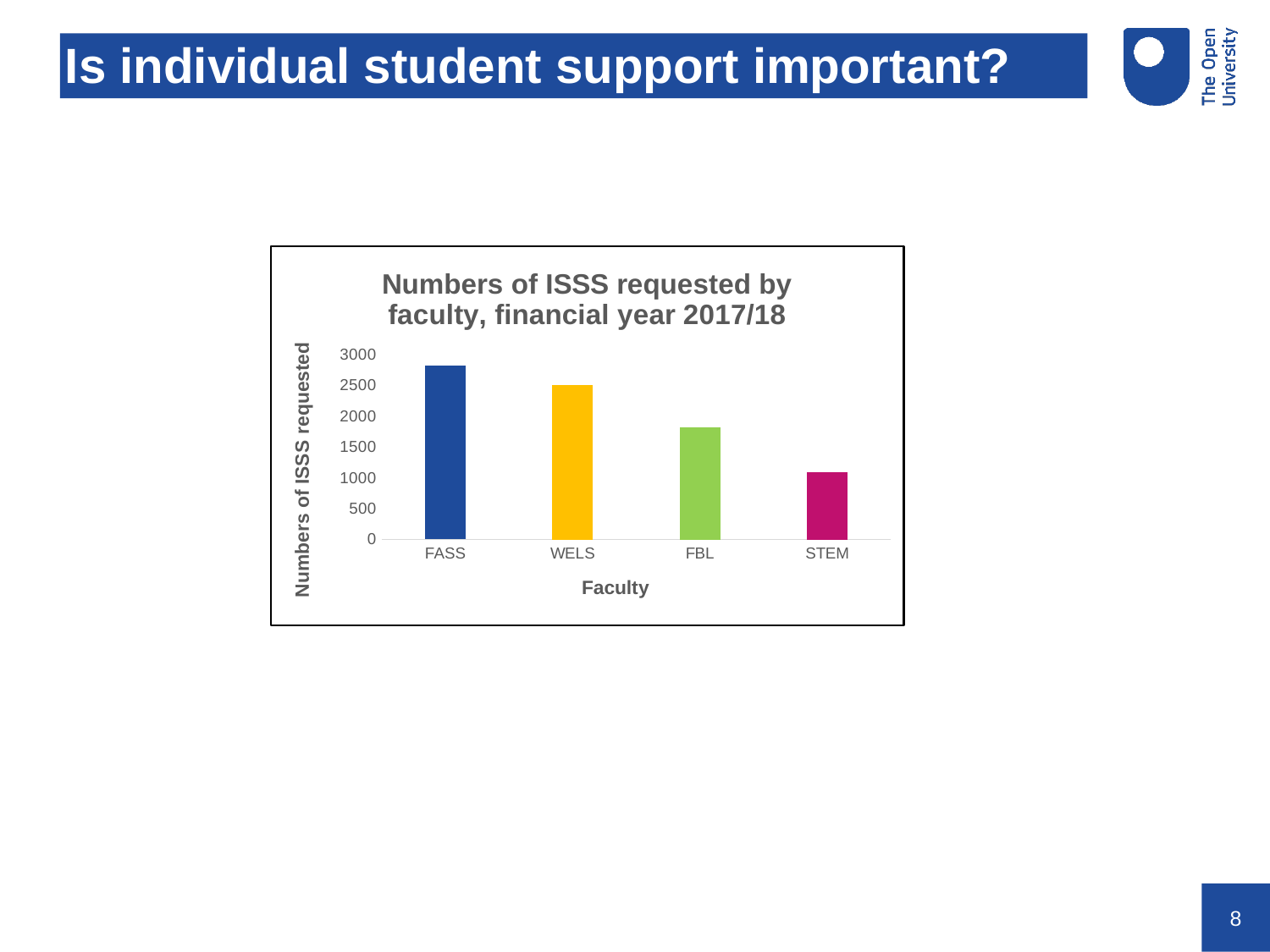
Is the value for FBL greater or less than 2000? less What kind of chart is shown on the slide? Bar chart What is the title of the chart? Numbers of ISSS requested by faculty, financial year 2017/18 Is the value for FASS greater or less than 2500? greater How many faculties are shown on the x axis of the chart? 4 Which faculty has the highest number of ISSS requested? FASS Do the values rise or fall moving from FASS to STEM along the x axis? Fall Which faculty has more ISSS requested, FASS or WELS? FASS What is the label on the x axis of the chart? Faculty Which faculty has more ISSS requested, FBL or STEM? FBL Is the value for STEM greater or less than 1500? less Which faculty has the lowest number of ISSS requested? STEM